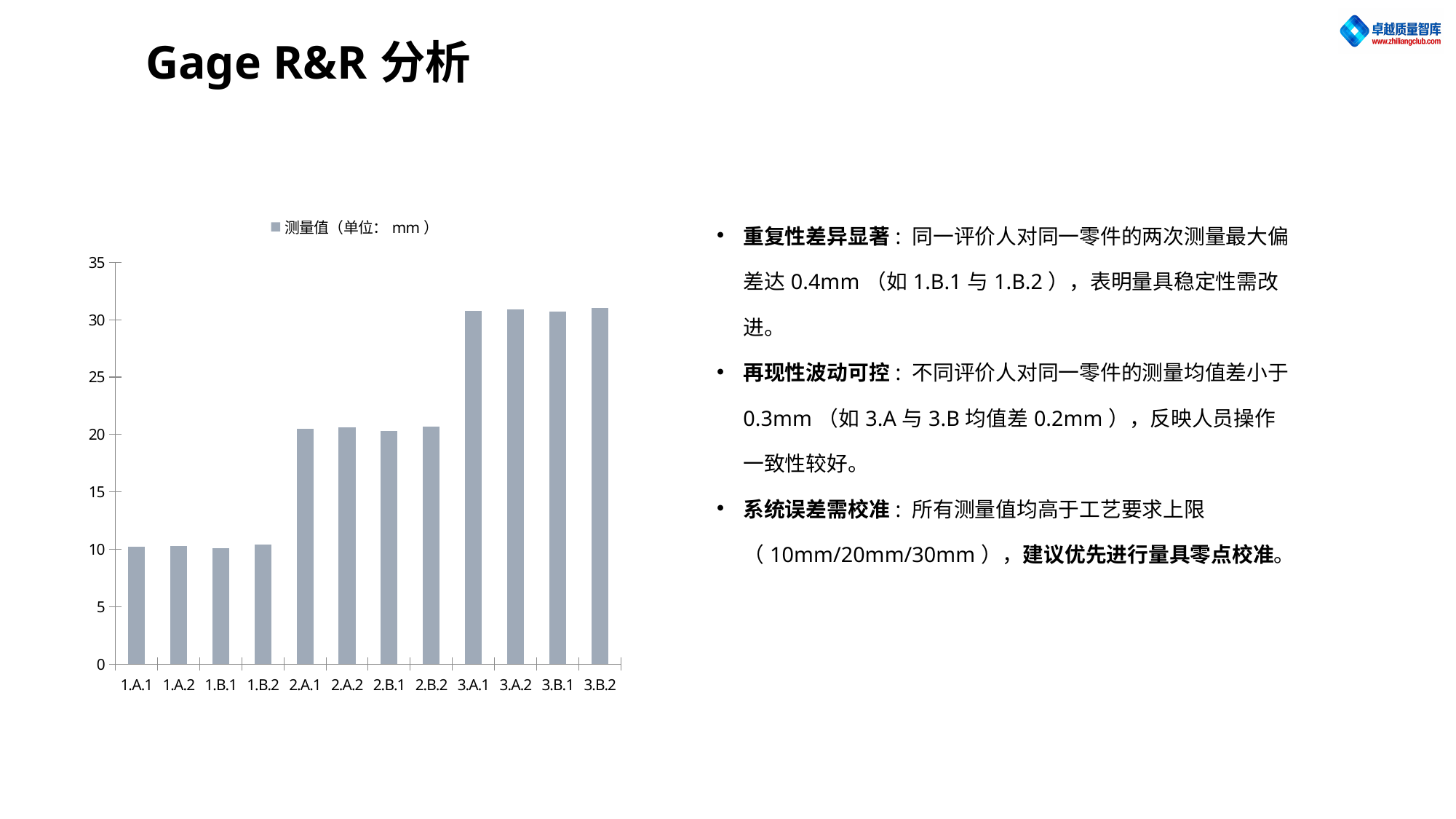
How many series does the chart's legend list? 1 Is the value for 1.A.1 greater or less than 15? less Is the value for 2.B.2 greater or less than 25? less Is the value for 3.A.1 greater or less than 25? greater Do the values generally rise or fall from 1.A.1 to 3.B.2 along the x axis? rise How many categories are plotted along the x axis of the chart? 12 Which is larger, the value for 2.A.2 or the value for 3.A.2? 3.A.2 What is the legend entry for the series in the chart? 测量值（单位： mm） What kind of chart is shown on the slide? bar chart Which is larger, the value for 3.B.2 or the value for 1.A.1? 3.B.2